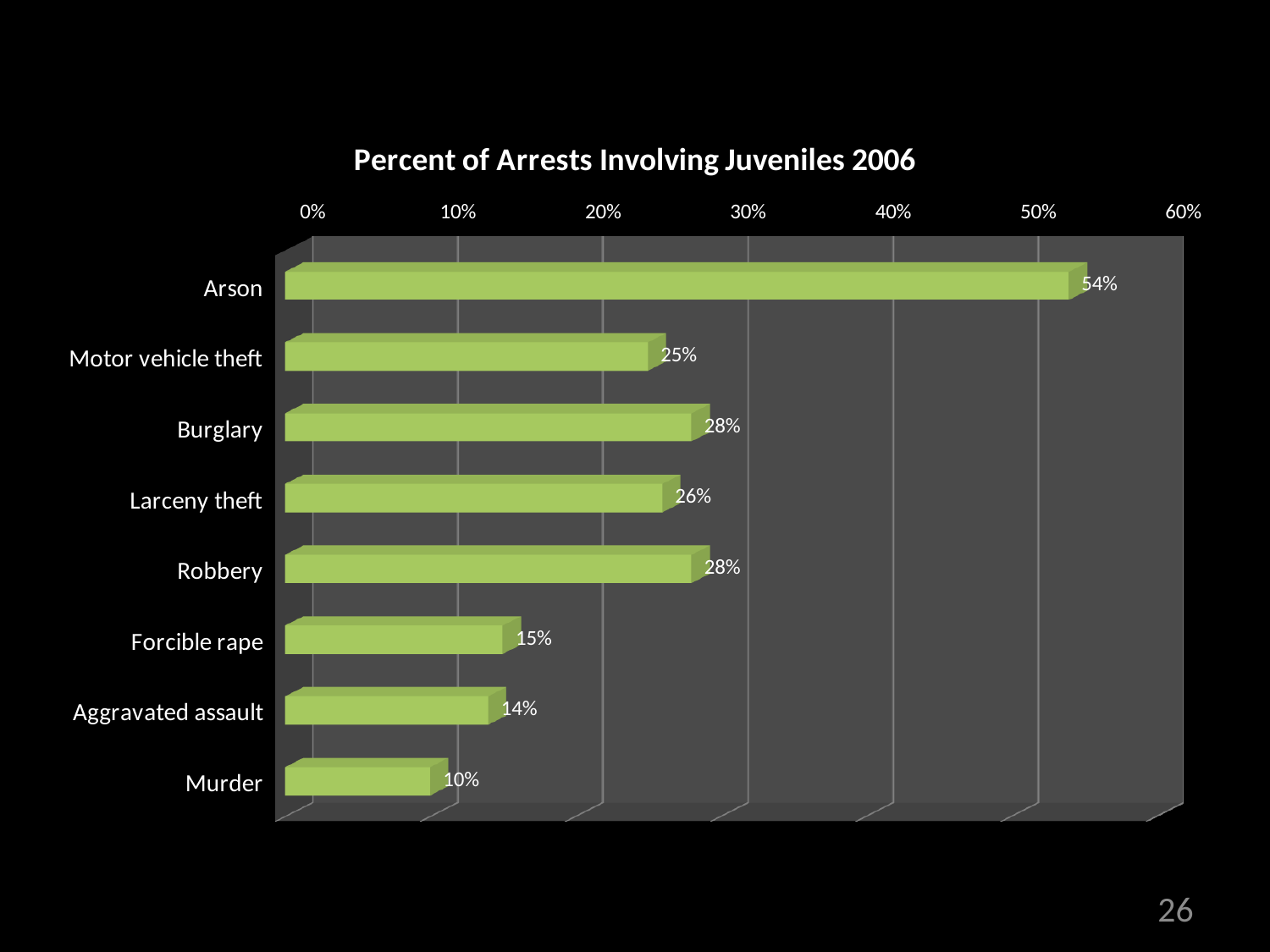
What is the value for Arson? 54% Is the value for Robbery greater or less than 20%? greater What is the value for Forcible rape? 15% Which category has the highest value? Arson Which is larger, the value for Larceny theft or the value for Aggravated assault? Larceny theft What is the value for Murder? 10% What is the title of the chart? Percent of Arrests Involving Juveniles 2006 What kind of chart is shown on the slide? Bar chart What is the difference between the values for Arson and Burglary? 26% How many categories are shown in the chart? 8 Which category has the lowest value? Murder What is the value for Motor vehicle theft? 25%